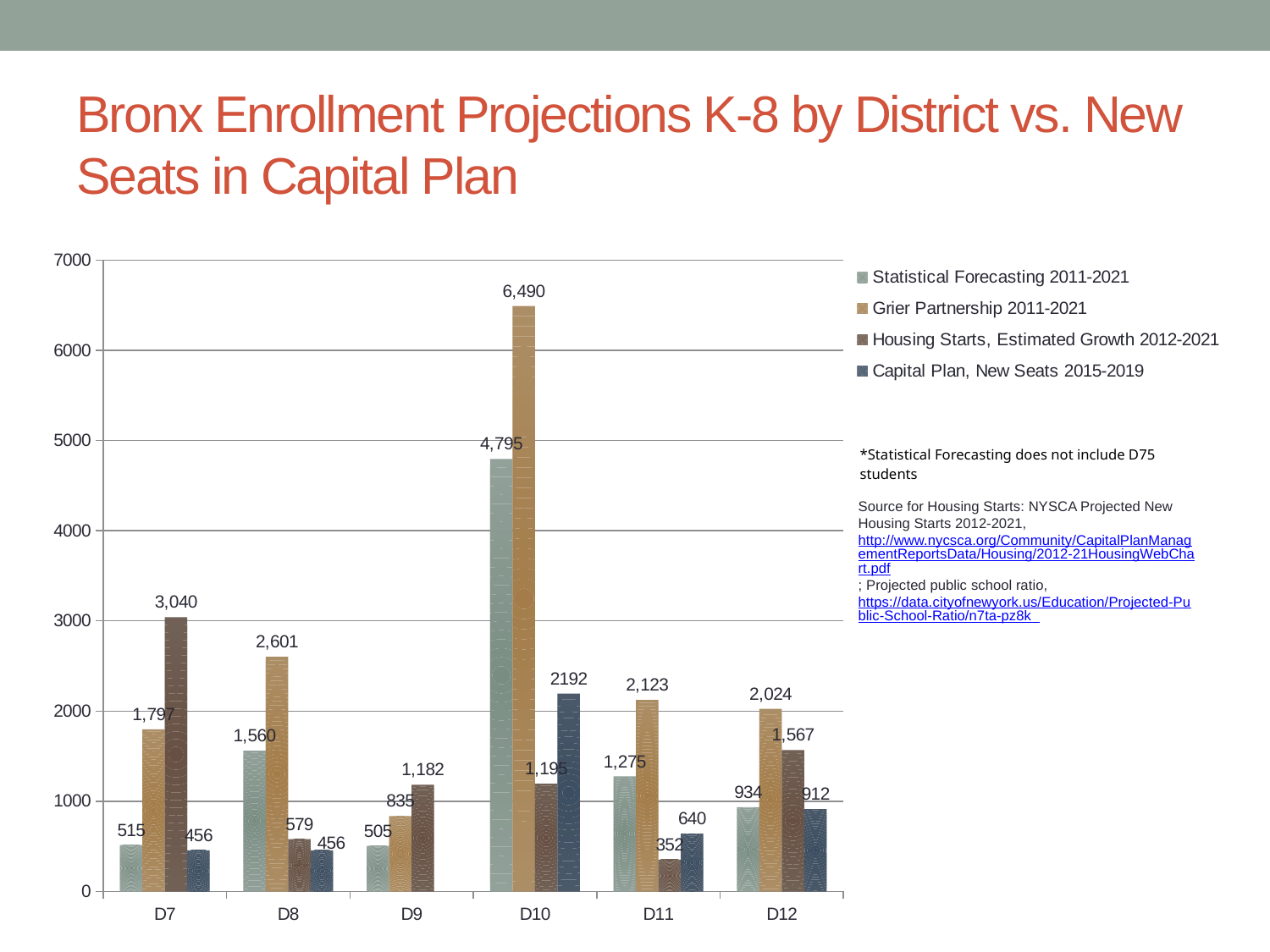
Is the Statistical Forecasting 2011-2021 value for D10 greater or less than 4000? greater What is the Grier Partnership 2011-2021 value for D10? 6,490 How many districts are shown on the x axis? 6 What is the difference between the Grier Partnership and Statistical Forecasting values for D10? 1,695 Which district has the highest Grier Partnership 2011-2021 value? D10 What is the difference between the Housing Starts and Capital Plan values for D7? 2,584 What is the Housing Starts, Estimated Growth 2012-2021 value for D7? 3,040 How many series does the legend list? 4 What kind of chart is shown on the slide? bar chart What is the Capital Plan, New Seats 2015-2019 value for D11? 640 Which district has the lowest Housing Starts, Estimated Growth 2012-2021 value? D11 For D12, which is larger: Housing Starts, Estimated Growth 2012-2021 or Capital Plan, New Seats 2015-2019? Housing Starts, Estimated Growth 2012-2021